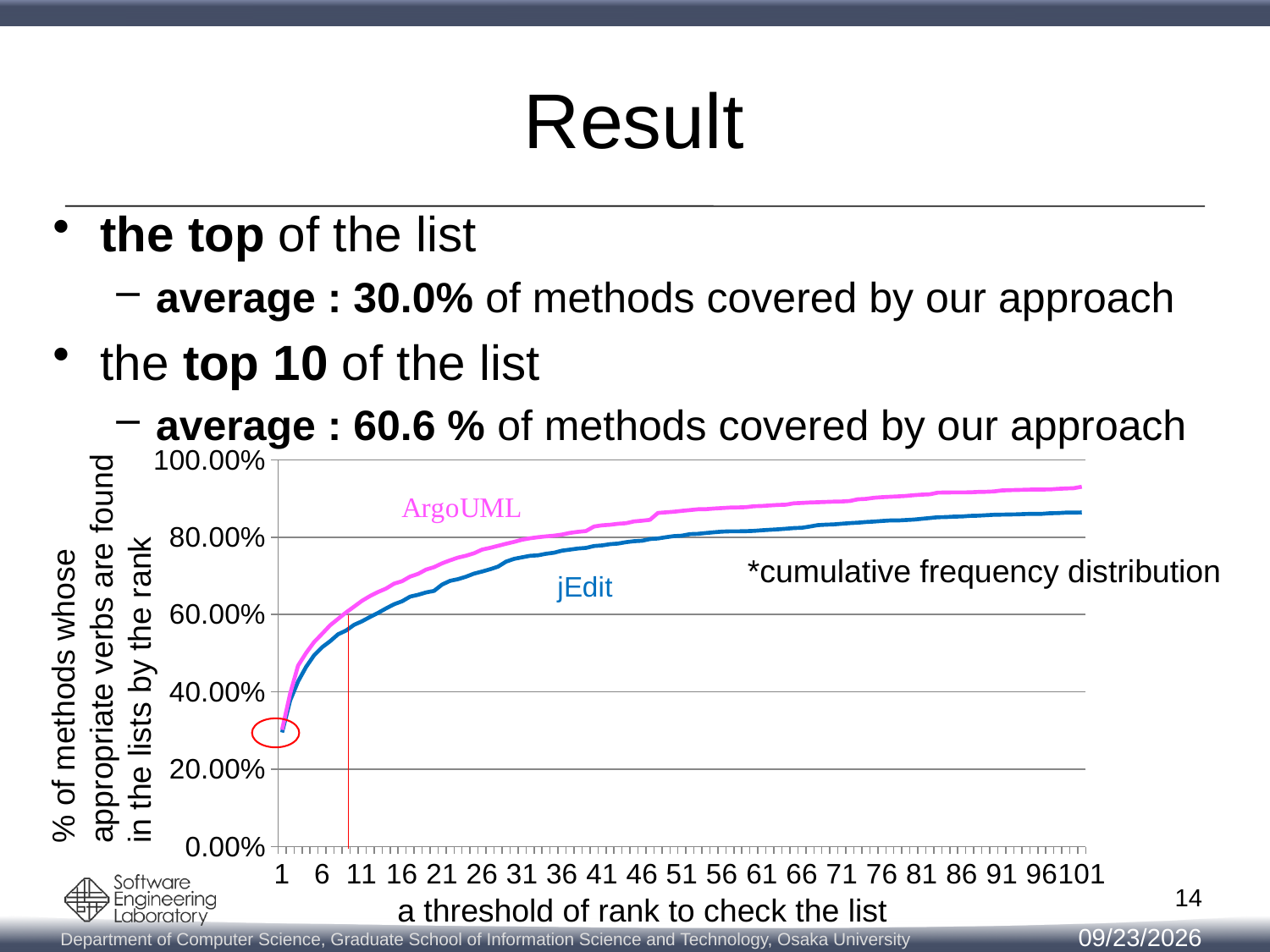
At a rank threshold of 101, which series has the higher value, ArgoUML or jEdit? ArgoUML Is the value for jEdit at a rank threshold of 1 greater or less than 40.00%? less Do the values for jEdit rise or fall as the rank threshold increases along the x axis? rise Do the values for ArgoUML rise or fall as the rank threshold increases along the x axis? rise How many series are plotted in the chart? 2 Is the value for ArgoUML at a rank threshold of 101 greater or less than 80.00%? greater What kind of chart is shown on the slide? line chart Is the value for jEdit at a rank threshold of 11 greater or less than 80.00%? less Which two series are labelled in the chart? ArgoUML and jEdit At a rank threshold of 31, which series has the higher value, ArgoUML or jEdit? ArgoUML What is the title of the x axis of the chart? a threshold of rank to check the list